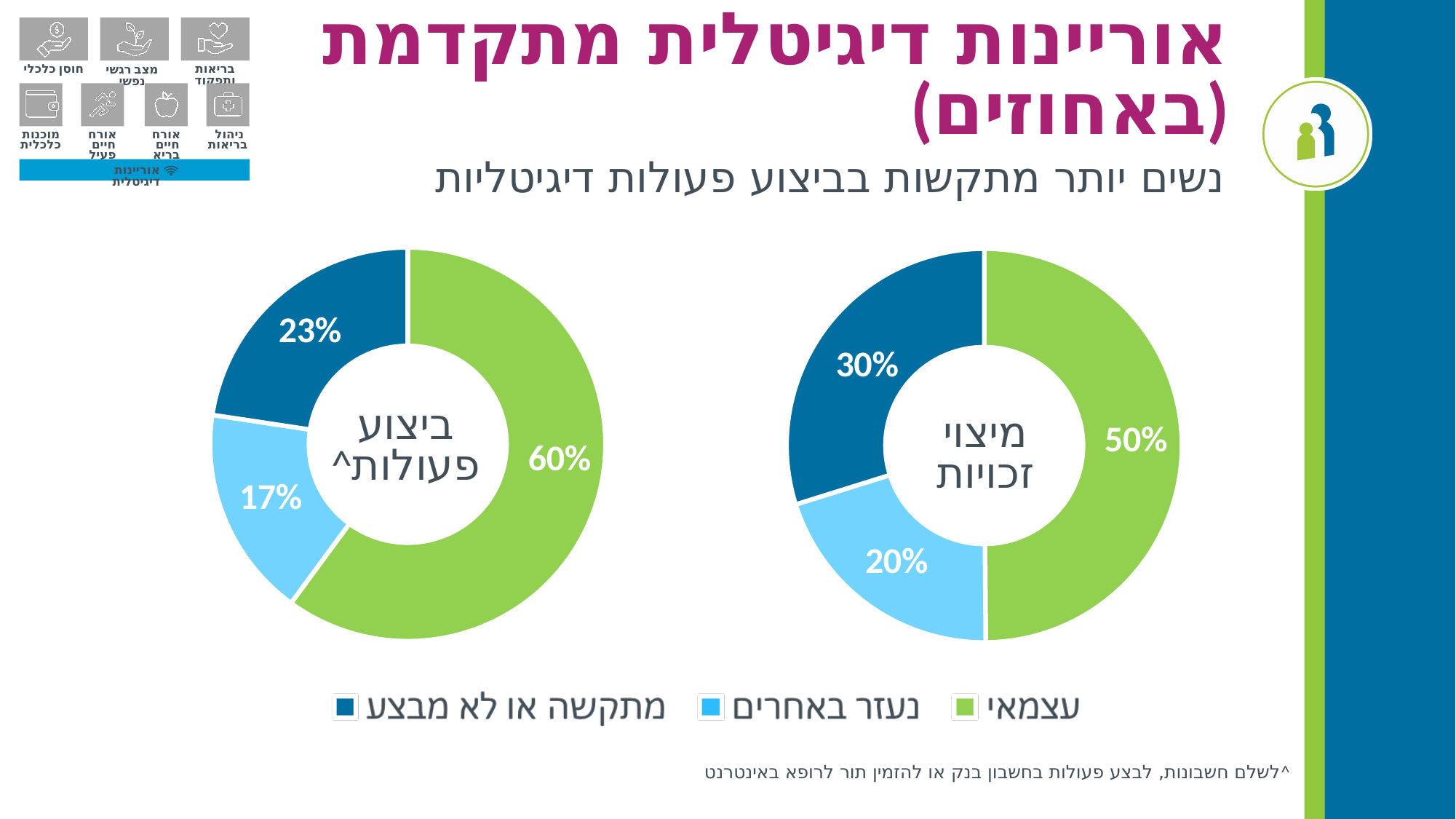
Which colour represents 'מתקשה או לא מבצע' in the legend? Dark blue In the 'ביצוע פעולות' chart, what is the difference between the 'עצמאי' share and the 'מתקשה או לא מבצע' share? 37% How many slices does the 'מיצוי זכויות' chart have? 3 In the 'מיצוי זכויות' chart, what share is labelled for 'מתקשה או לא מבצע'? 30% In the 'מיצוי זכויות' chart, which category has the smallest slice? נעזר באחרים In the 'ביצוע פעולות' chart, what share is labelled for 'עצמאי'? 60% How many entries does the legend list? 3 What kind of chart is the 'ביצוע פעולות' chart? Donut (pie) chart Which chart has the larger 'עצמאי' share, 'ביצוע פעולות' or 'מיצוי זכויות'? ביצוע פעולות In the 'ביצוע פעולות' chart, what share is labelled for 'נעזר באחרים'? 17% In the 'מיצוי זכויות' chart, what share is labelled for 'נעזר באחרים'? 20% In the 'ביצוע פעולות' chart, which category has the largest slice? עצמאי